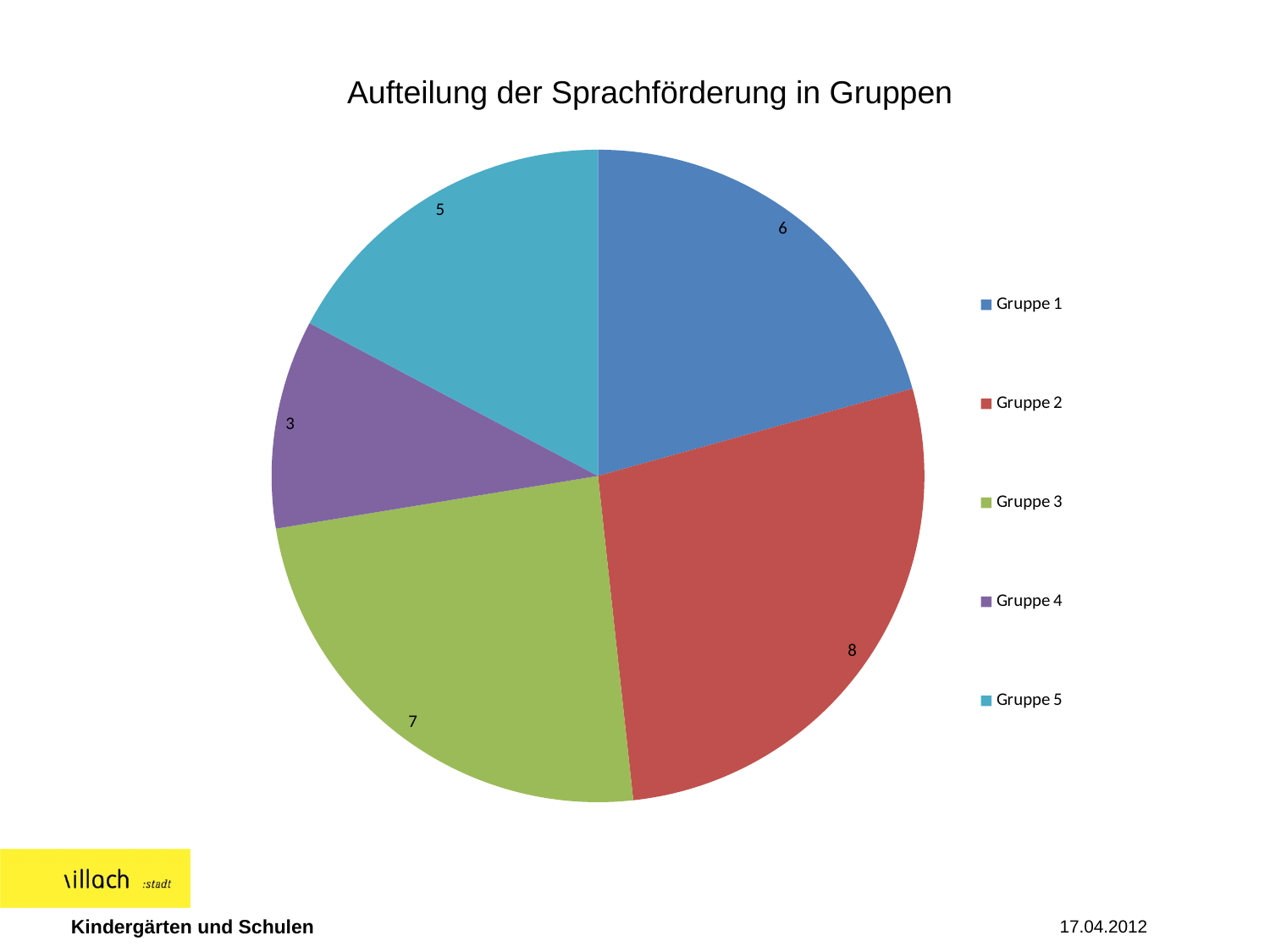
What is the title of the chart? Aufteilung der Sprachförderung in Gruppen What is the difference between the values for Gruppe 2 and Gruppe 4? 5 What is the value for Gruppe 5? 5 What kind of chart is shown on the slide? Pie chart Which group has the largest slice of the pie? Gruppe 2 What is the value for Gruppe 2? 8 Which is larger, the value for Gruppe 1 or the value for Gruppe 5? Gruppe 1 What is the value for Gruppe 4? 3 How many slices does the pie chart have? 5 What is the total of all the slice values in the pie chart? 29 Which group has the smallest slice of the pie? Gruppe 4 What is the difference between the values for Gruppe 3 and Gruppe 1? 1